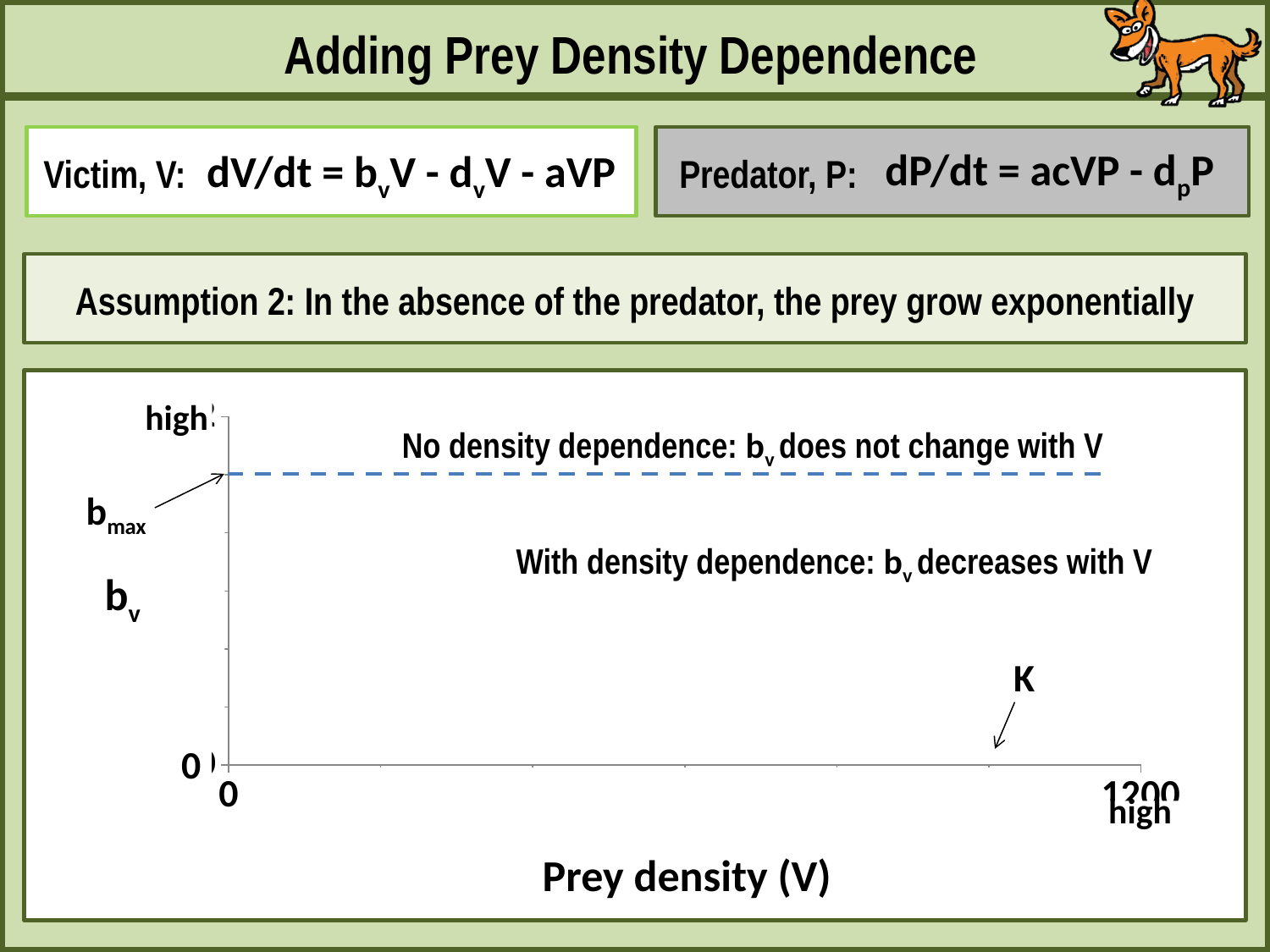
What kind of chart is shown on the slide? line chart What is the largest numeric tick value shown on the x axis? 1200 How many plotted lines are drawn on the chart? 1 According to the chart annotation, what happens to b_v with density dependence as V increases? b_v decreases with V What is the lowest tick value shown on the x axis? 0 What is the label of the x axis of the chart? Prey density (V) Does the dashed line for 'No density dependence' rise, fall, or stay flat as prey density (V) increases? stays flat